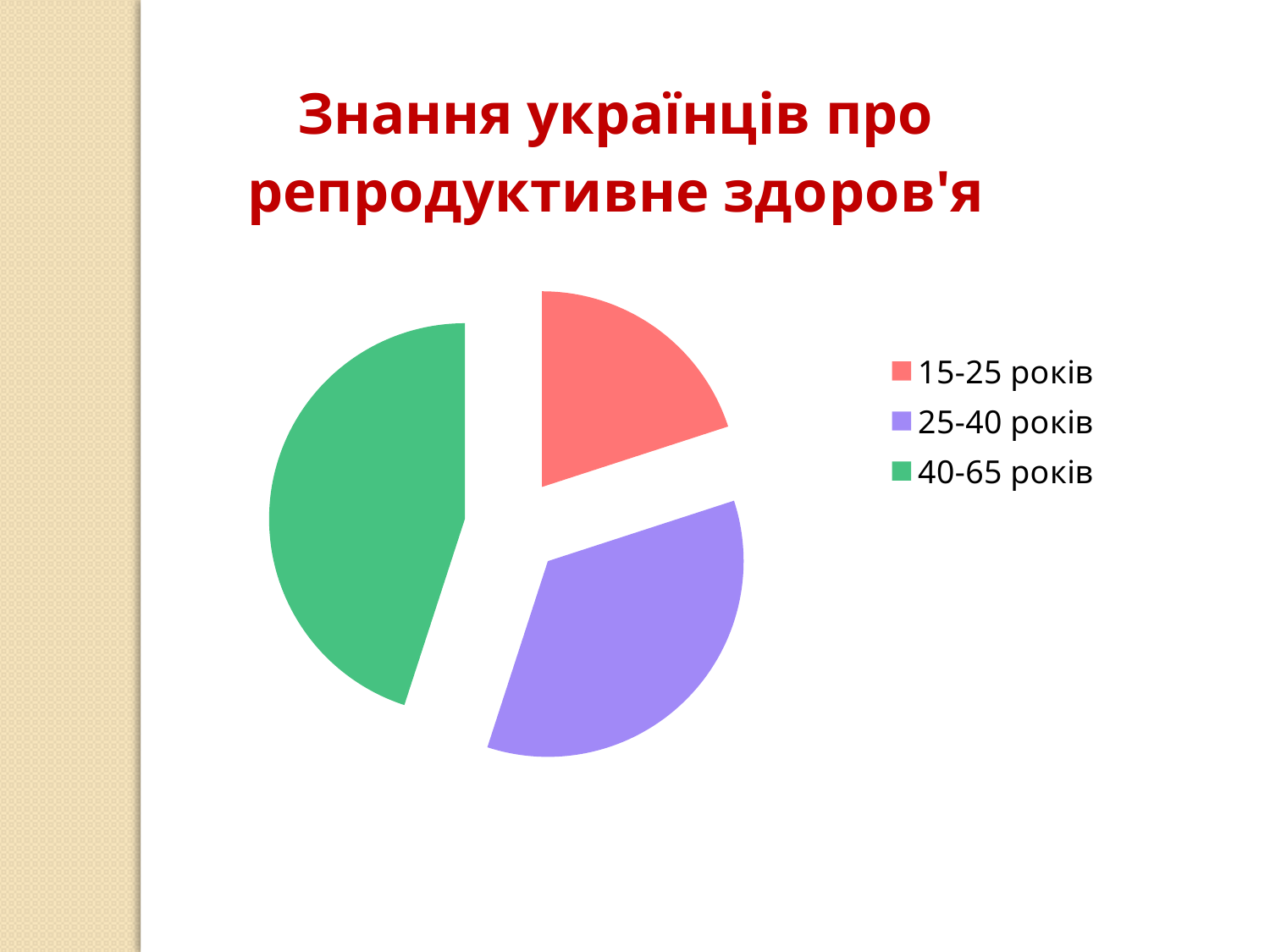
What kind of chart is shown on the slide? pie chart What colour is the slice for 40-65 років in the pie chart? green How many slices does the pie chart have? 3 What is the title of the chart on the slide? Знання українців про репродуктивне здоров'я How many entries does the legend of the pie chart list? 3 Which age group has the smallest slice of the pie chart? 15-25 років Which slice is larger: 15-25 років or 25-40 років? 25-40 років Which slice is larger: 25-40 років or 40-65 років? 40-65 років Which age group has the largest slice of the pie chart? 40-65 років